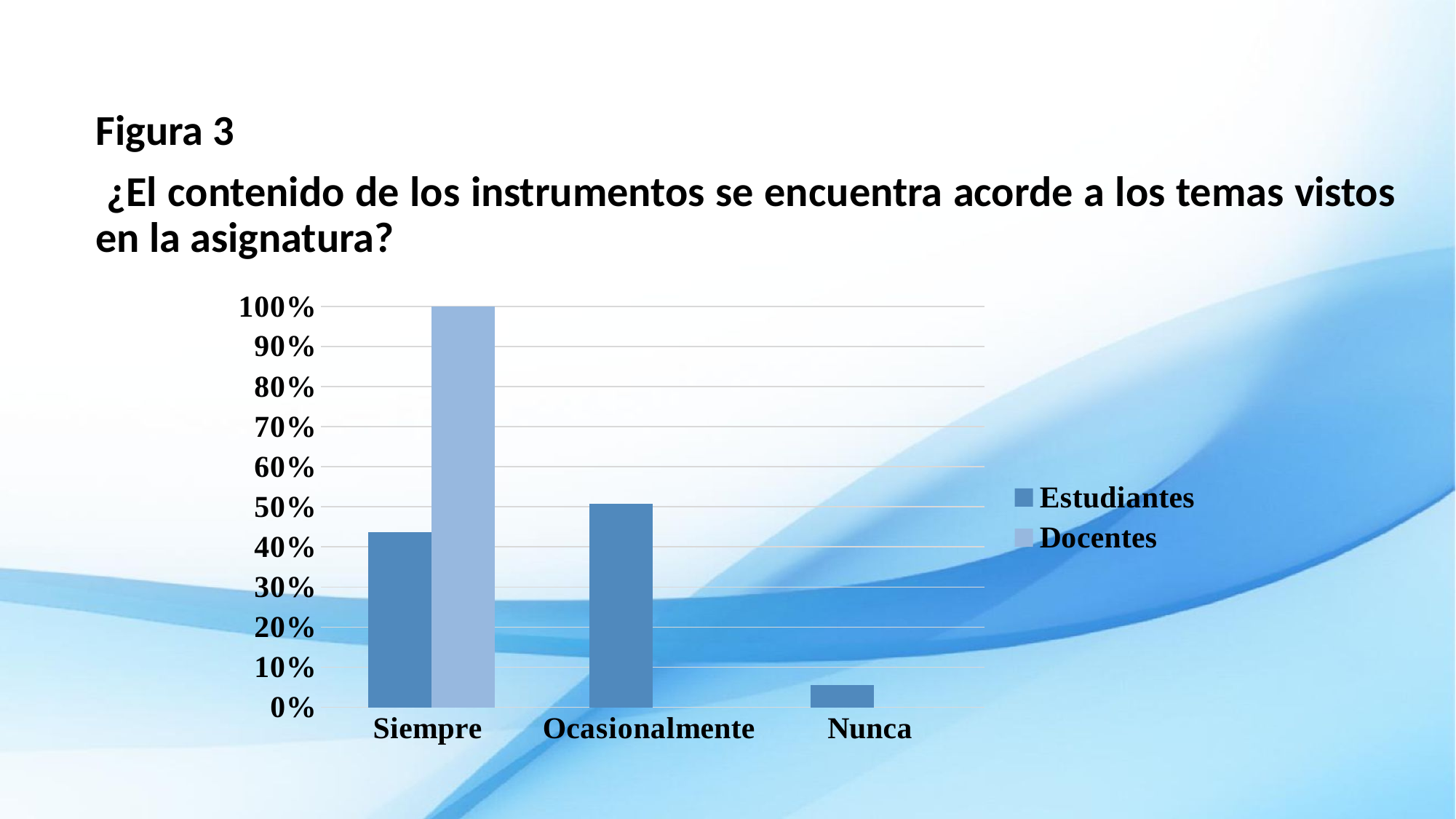
Which category has the lowest value for Estudiantes? Nunca What is the value for Docentes in the Siempre category? 100% What are the two series names listed in the legend? Estudiantes and Docentes In the Siempre category, which series has the larger value, Estudiantes or Docentes? Docentes Which category has the highest value for Estudiantes? Ocasionalmente Is the value for Estudiantes in the Nunca category greater or less than 10%? less Which series is larger for Estudiantes: Siempre or Ocasionalmente? Ocasionalmente How many series does the legend list? 2 What kind of chart is shown on the slide? bar chart How many categories are shown on the x axis? 3 Is the value for Estudiantes in the Siempre category greater or less than 50%? less